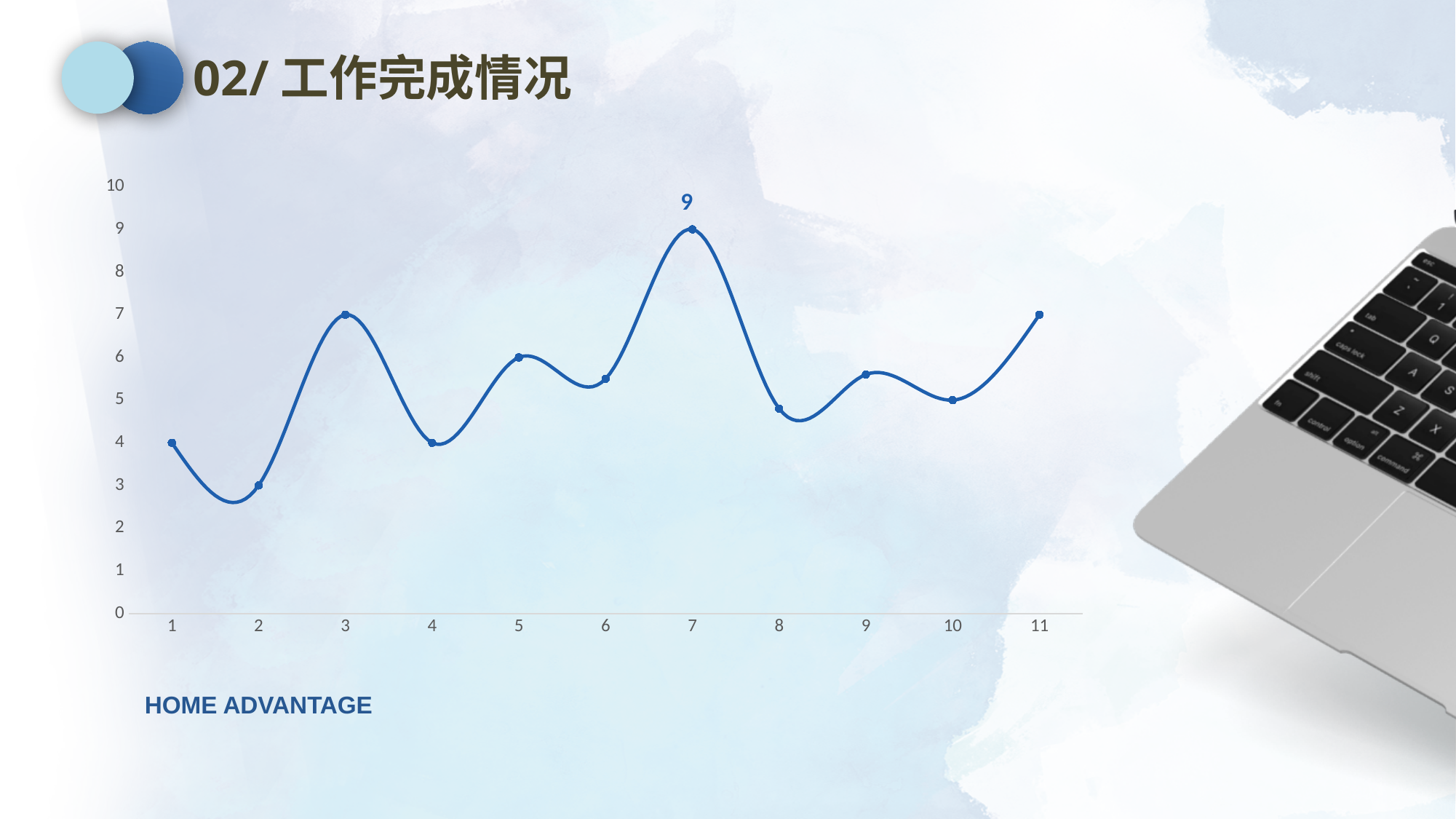
How many data points are plotted on the line? 11 Which has the larger value, x = 3 or x = 5? x = 3 At which x value does the line reach its highest point? 7 Does the line rise or fall from x = 1 to x = 2? fall At which x value does the line reach its lowest point? 2 Is the value at x = 8 greater or less than 5? less What kind of chart is shown on the slide? line chart What is the value at x = 7, the point with a data label? 9 What is the value at x = 10? 5 What is the value at x = 3? 7 What is the value at x = 2? 3 What is the difference between the value at x = 7 and the value at x = 2? 6